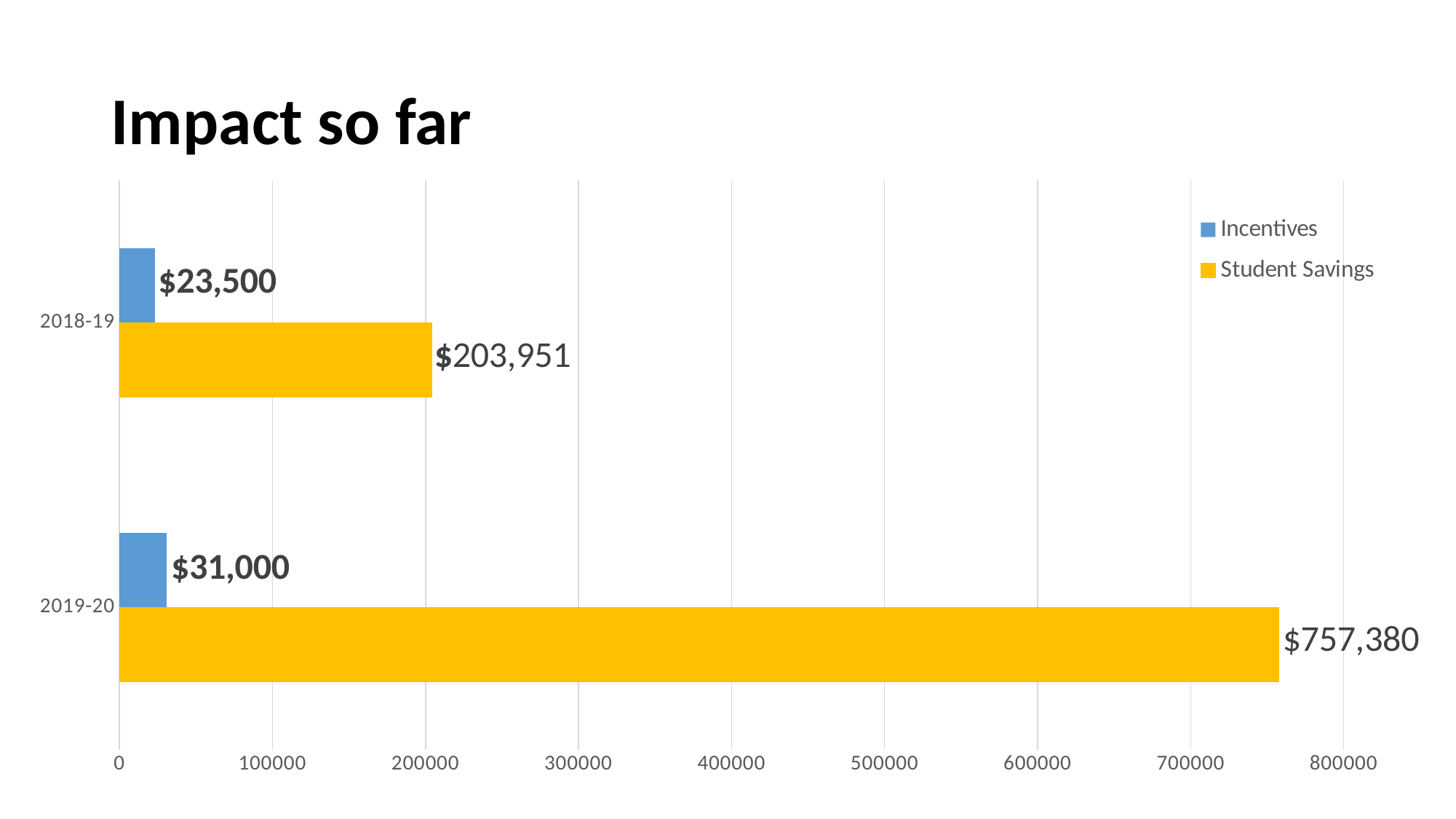
What is the Incentives value for 2018-19? $23,500 Which is larger: Student Savings in 2018-19 or Incentives in 2019-20? Student Savings in 2018-19 How many series does the legend list? 2 What is the difference between Student Savings in 2019-20 and 2018-19? $553,429 What is the Incentives value for 2019-20? $31,000 What is the difference between Incentives in 2019-20 and 2018-19? $7,500 What is the Student Savings value for 2019-20? $757,380 Which year has the higher Student Savings? 2019-20 What kind of chart is shown on the slide? Bar chart Which year has the lower Incentives value? 2018-19 What is the title of the slide containing the chart? Impact so far What is the Student Savings value for 2018-19? $203,951